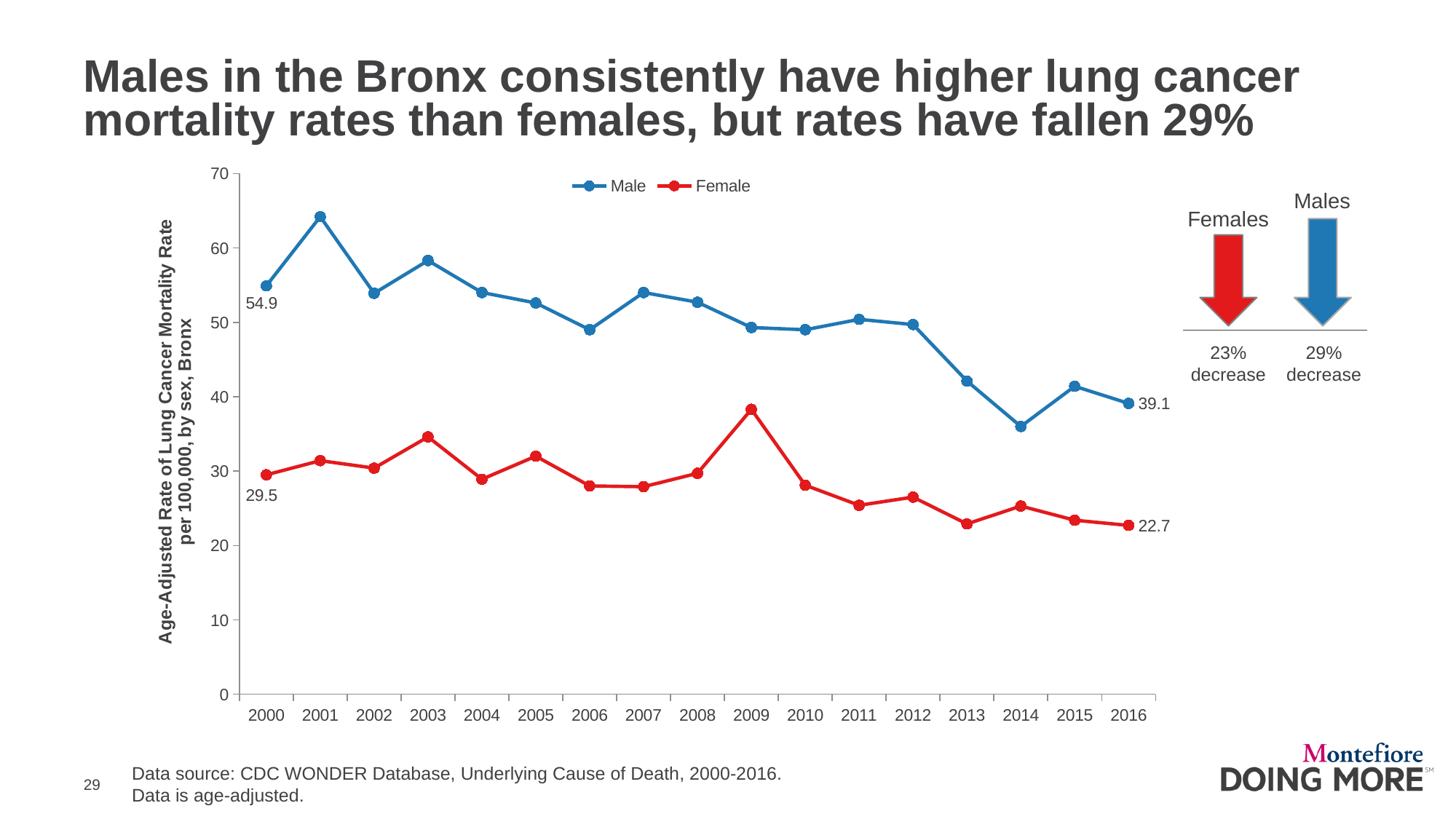
What is the Male lung cancer mortality rate in 2000? 54.9 Is the Male rate in 2001 greater or less than 60? greater In which year was the Female rate highest? 2009 What is the Male lung cancer mortality rate in 2016? 39.1 By how much did the Male rate fall from 2000 to 2016? 15.8 How many series does the legend list? 2 What is the difference between the Male and Female rates in 2000? 25.4 In which year was the Male rate lowest? 2014 How many years are plotted on the x axis? 17 What is the Female lung cancer mortality rate in 2016? 22.7 What kind of chart is shown on the slide? line chart In which year was the Male rate highest? 2001